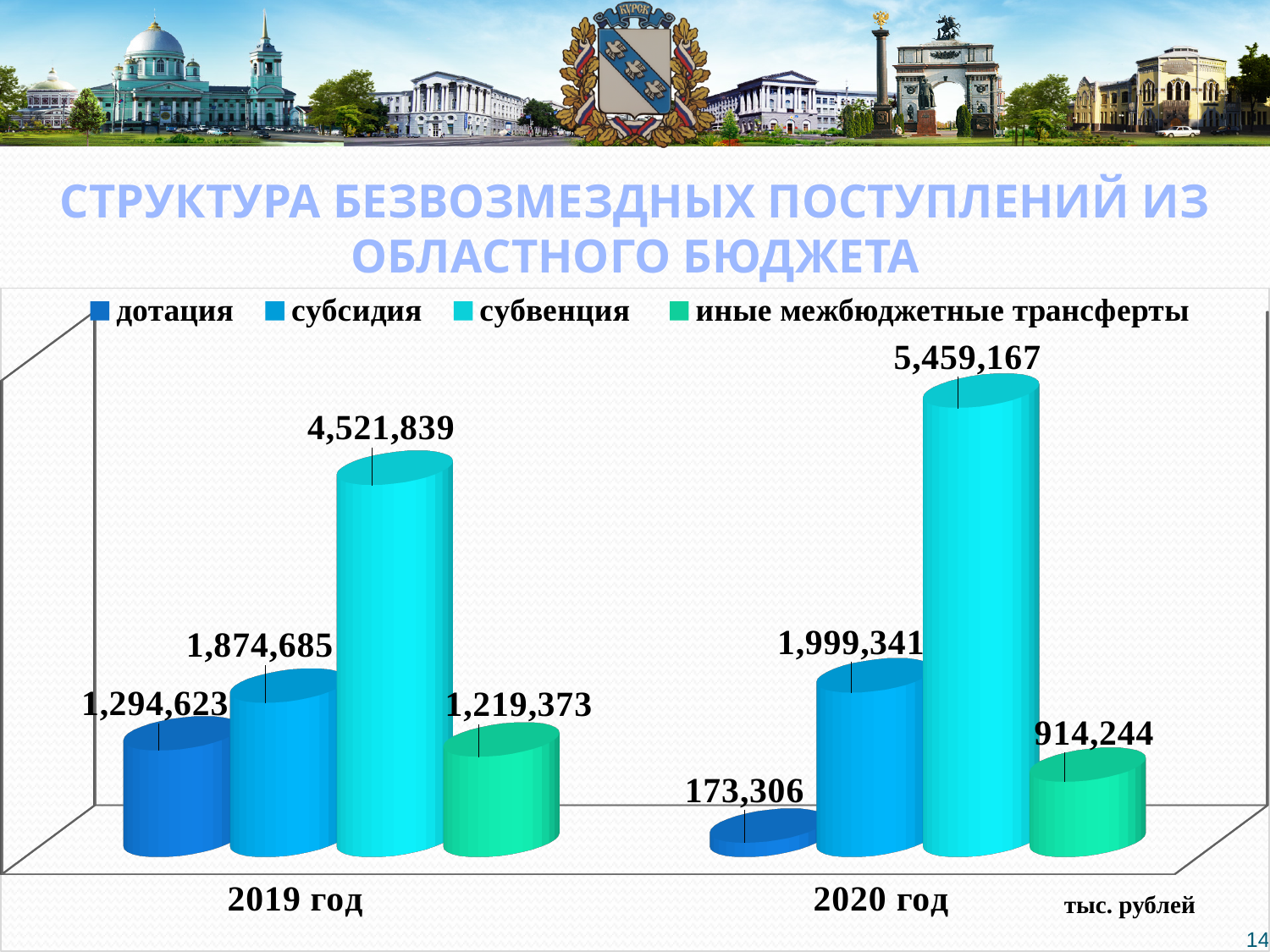
What is the value for субвенция in 2019 год? 4,521,839 By how much did субвенция increase from 2019 год to 2020 год? 937,328 How many series does the legend list? 4 What unit is indicated at the bottom right of the chart? тыс. рублей Which is larger: субсидия in 2019 год or субсидия in 2020 год? субсидия in 2020 год Which series has the highest value in 2020 год? субвенция Which series has the lowest value in 2020 год? дотация What is the value for дотация in 2020 год? 173,306 What is the value for субсидия in 2020 год? 1,999,341 What kind of chart is shown on the slide? bar chart What is the difference between дотация in 2019 год and дотация in 2020 год? 1,121,317 What is the value for иные межбюджетные трансферты in 2019 год? 1,219,373